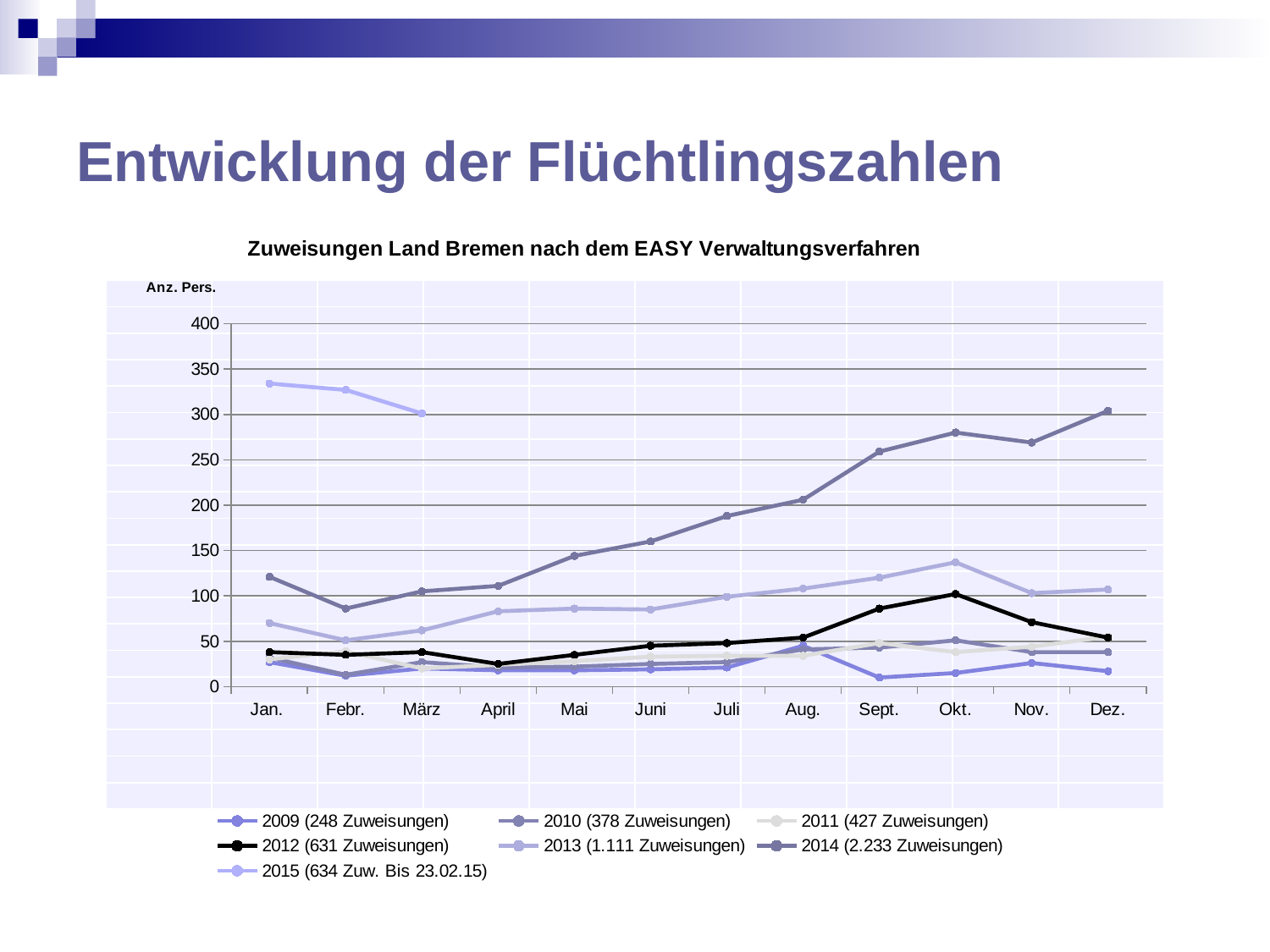
Is the value for the 2009 series in Sept. greater or less than 50? less What is the title of the chart? Zuweisungen Land Bremen nach dem EASY Verwaltungsverfahren How many months are shown along the x axis? 12 Is the value for the 2014 series in Okt. greater or less than 250? greater Does the 2015 series rise or fall from Jan. to März? fall How many series does the legend list? 7 Is the value for the 2014 series in Jan. greater or less than 100? greater In which month is the 2014 series at its lowest? Febr. In Dez., which series has the larger value, 2014 or 2013? 2014 Which series in the legend is labelled with 2.233 Zuweisungen? 2014 What kind of chart is shown on the slide? line chart